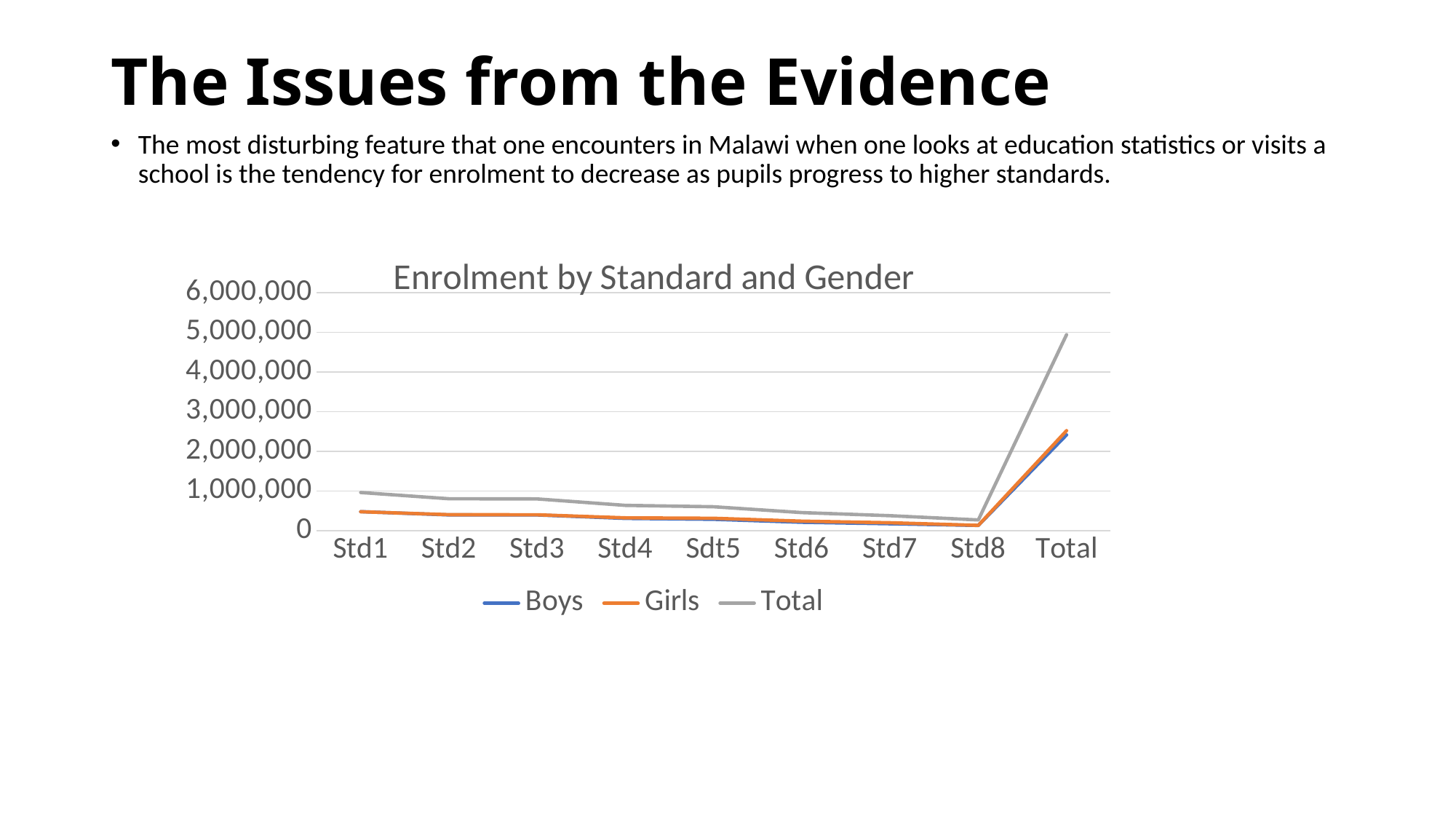
Is the value of the Boys series at the Total category greater or less than 2,000,000? greater Which series are listed in the chart's legend? Boys, Girls, Total How many categories are shown along the x axis of the chart? 9 What kind of chart is shown on the slide? line chart What is the title of the chart? Enrolment by Standard and Gender How many series does the chart's legend list? 3 Is the value of the Total series at Std8 greater or less than 1,000,000? less Does the Total series rise or fall from Std1 to Std8? fall Is the value of the Total series at Std1 greater or less than 2,000,000? less At which category does the Total series reach its highest value? Total At which category does the Total series reach its lowest value? Std8